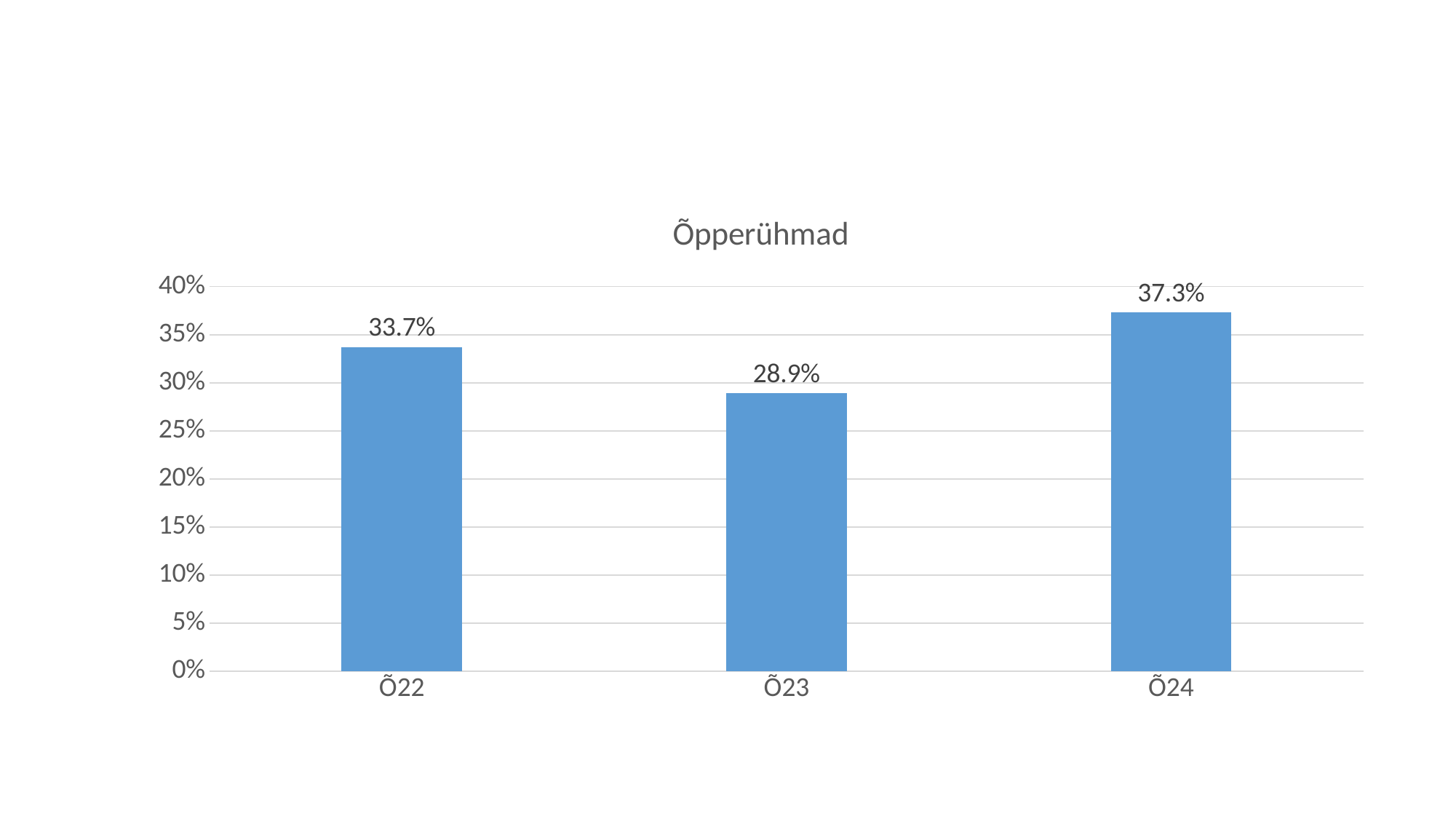
What is the value for Õ22? 33.7% Which is larger, the value for Õ22 or the value for Õ24? Õ24 What is the difference between the values for Õ22 and Õ23? 4.8% Is the value for Õ23 greater or less than 30%? less What is the value for Õ24? 37.3% What is the difference between the values for Õ24 and Õ23? 8.4% What kind of chart is shown on the slide? bar chart Which category has the lowest value? Õ23 What is the title of the chart? Õpperühmad How many categories are shown on the x axis? 3 Which category has the highest value? Õ24 What is the value for Õ23? 28.9%